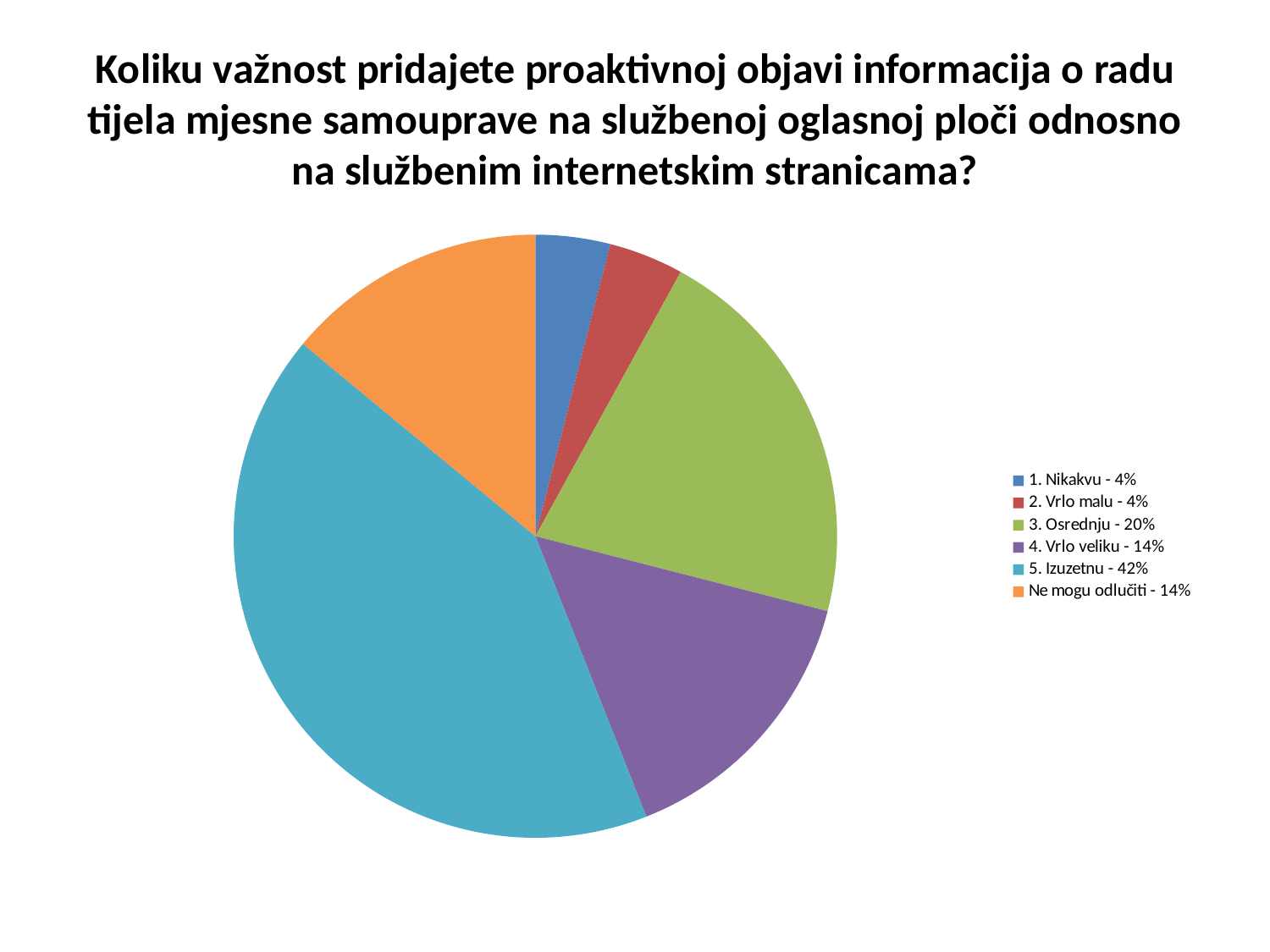
What is the difference in percentage points between "5. Izuzetnu" and "3. Osrednju"? 22 How many slices does the pie chart have? 6 What share of the pie does "5. Izuzetnu" represent? 42% What share of the pie does "Ne mogu odlučiti" represent? 14% What share of the pie does "1. Nikakvu" represent? 4% Which is larger, the share for "3. Osrednju" or the share for "4. Vrlo veliku"? 3. Osrednju How many entries does the legend list? 6 Which category has the largest share of the pie? 5. Izuzetnu What kind of chart is shown on the slide? pie chart What colour is the slice for "5. Izuzetnu"? teal/light blue What is the combined share of "4. Vrlo veliku" and "Ne mogu odlučiti"? 28%